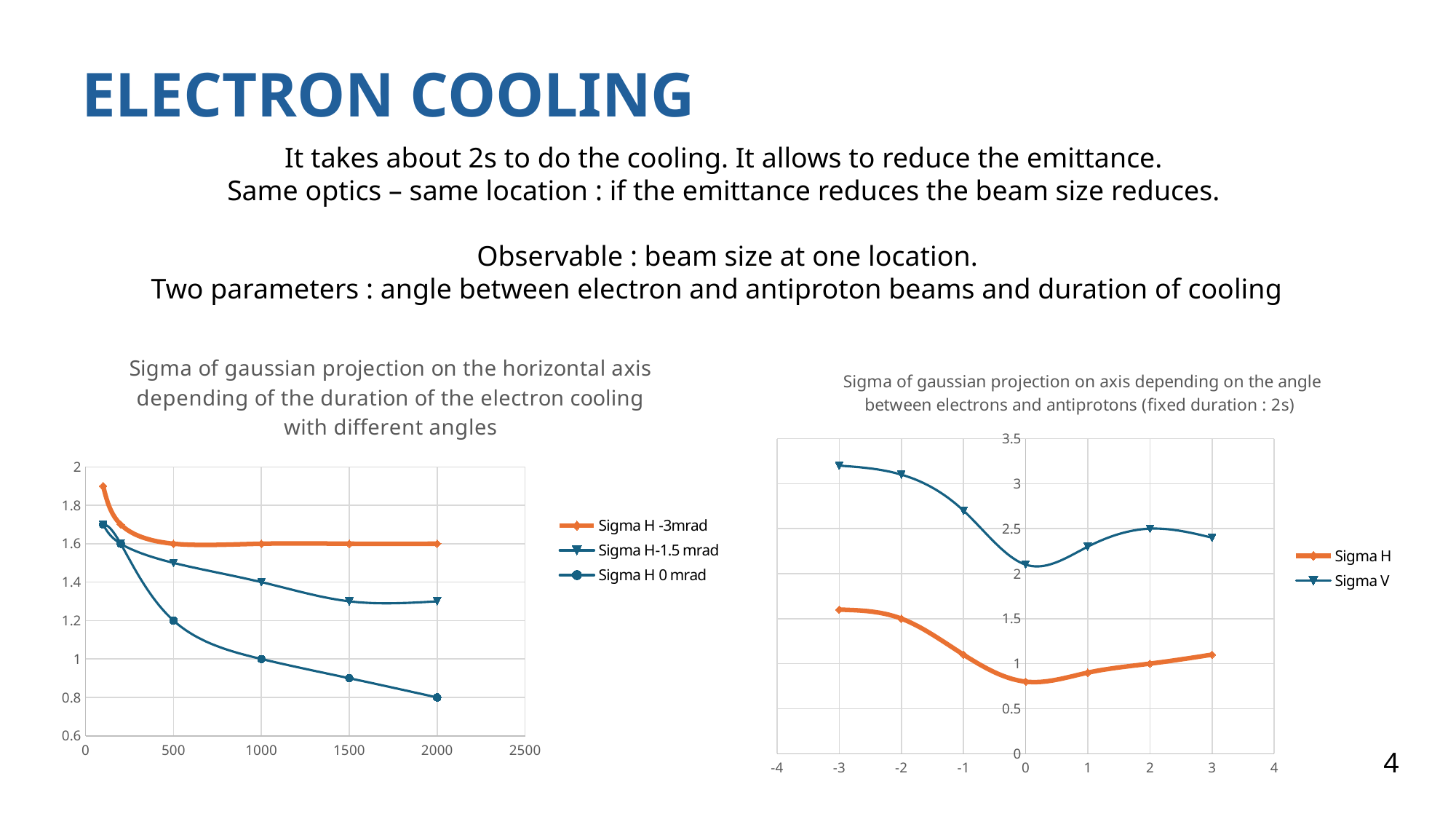
In the left chart, does the Sigma H 0 mrad series rise or fall as the duration increases? fall What type of chart is the left chart, 'Sigma of gaussian projection on the horizontal axis depending of the duration of the electron cooling with different angles'? line chart In the left chart, what is the value of Sigma H 0 mrad at a duration of 2000? 0.8 In the right chart, is the value of Sigma H at angle 0 greater or less than 1? less In the left chart, which series has the lowest value at a duration of 2000? Sigma H 0 mrad How many series does the legend of the right chart list? 2 In the left chart, what is the value of Sigma H 0 mrad at a duration of 1000? 1 In the right chart, is the value of Sigma V at angle -3 greater or less than 3? greater In the left chart, which is larger at a duration of 1500: Sigma H -3mrad or Sigma H 0 mrad? Sigma H -3mrad In the left chart, what is the value of Sigma H-1.5 mrad at a duration of 1000? 1.4 How many series does the legend of the left chart list? 3 In the right chart, which series has the higher values across all angles: Sigma H or Sigma V? Sigma V